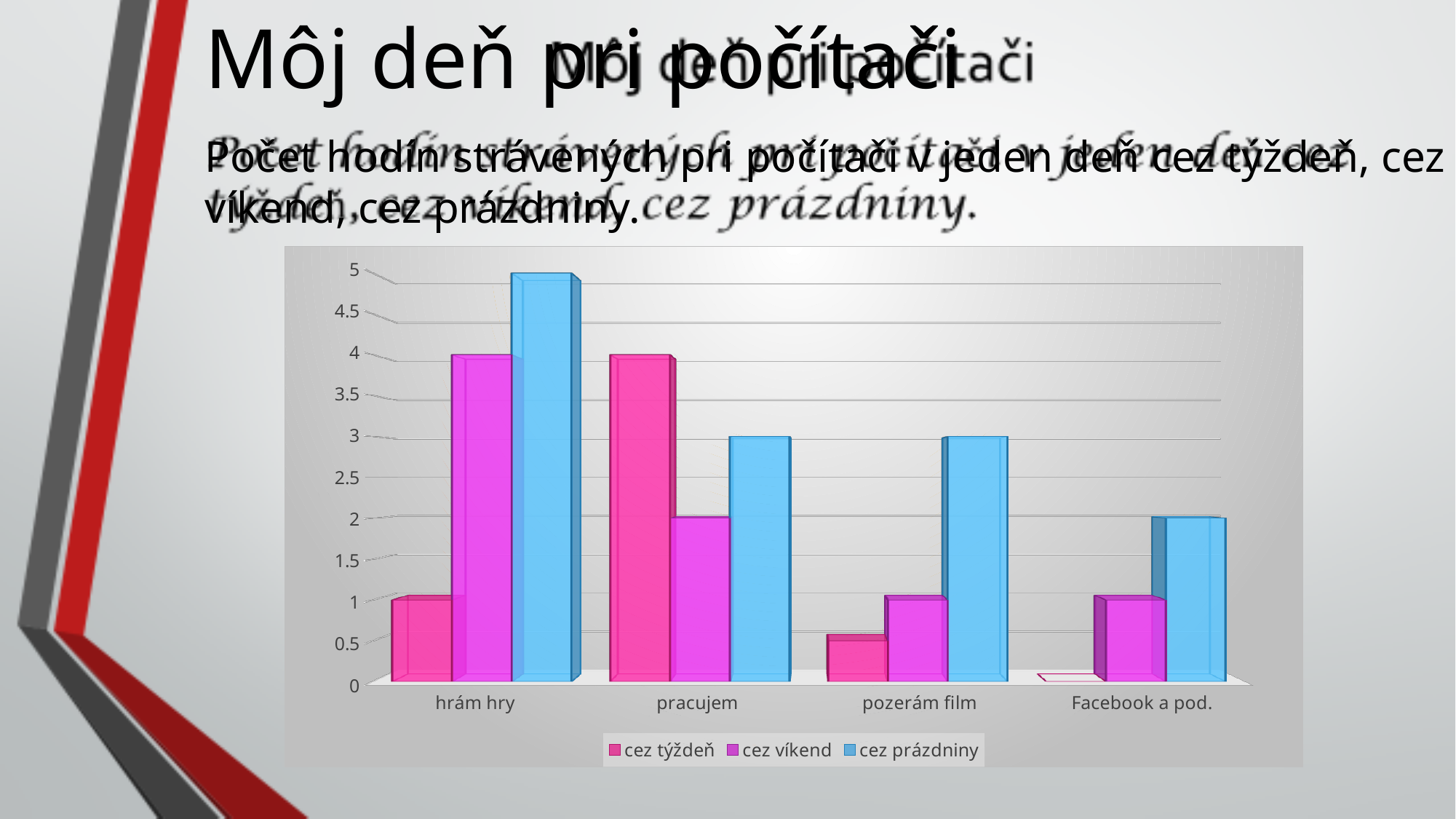
Is the value for 'cez prázdniny' in 'Facebook a pod.' greater or less than 1? greater Which series is shown in blue in the legend? cez prázdniny Which category has the lowest 'cez týždeň' value? Facebook a pod. What kind of chart is shown on the slide? bar chart How many categories are shown on the x axis? 4 Which category has the highest 'cez prázdniny' value? hrám hry What is the value for 'cez víkend' in the 'hrám hry' category? 4 How many series does the legend list? 3 What is the value for 'cez týždeň' in the 'pracujem' category? 4 Is the value for 'cez týždeň' in 'pozerám film' greater or less than 1? less In the 'pracujem' category, which is larger: 'cez týždeň' or 'cez víkend'? cez týždeň What is the value for 'cez prázdniny' in the 'hrám hry' category? 5